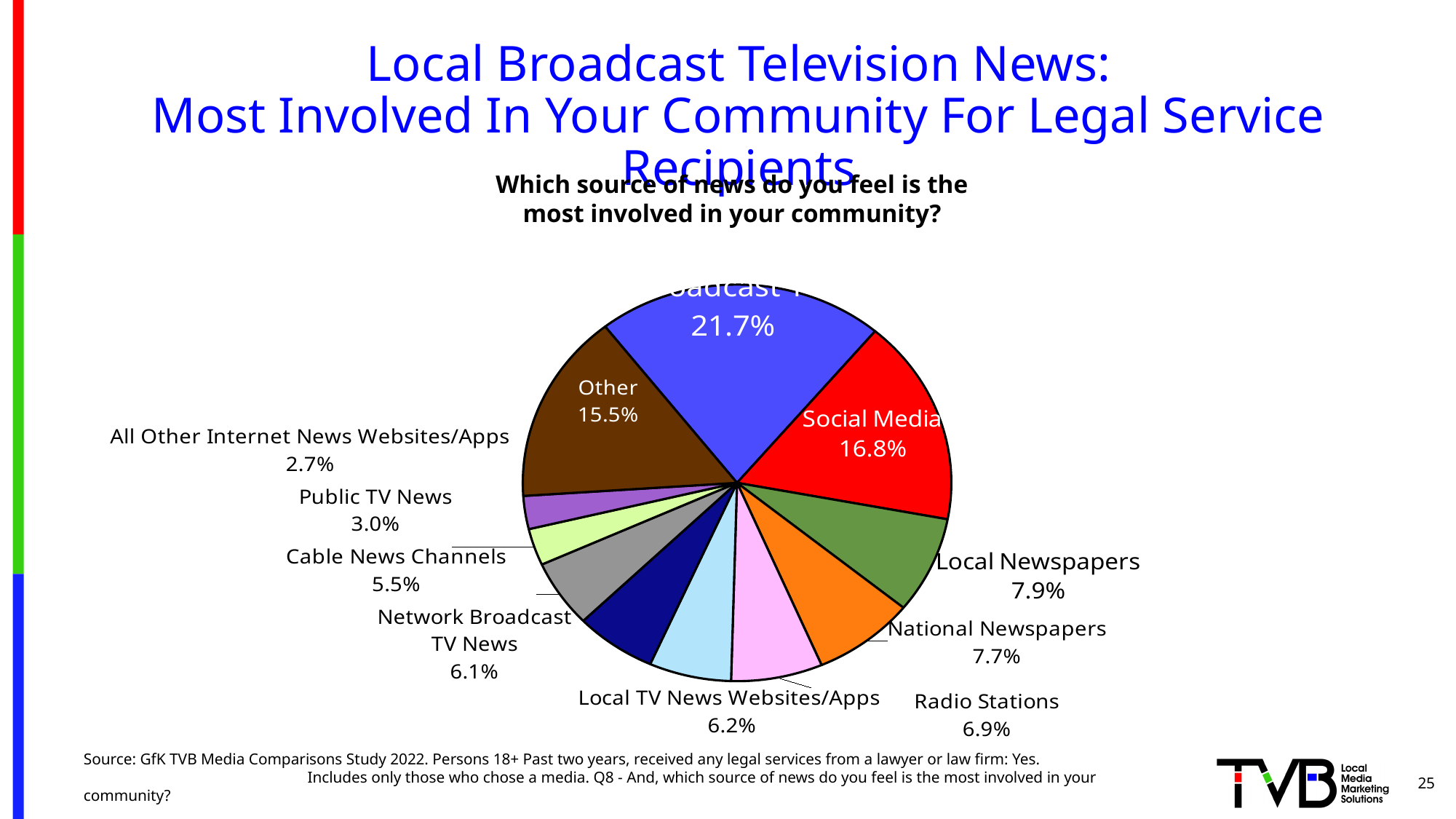
Which category has the smallest slice of the pie? All Other Internet News Websites/Apps What is the difference in percentage points between Social Media and Other? 1.3 percentage points What kind of chart is shown on the slide? Pie chart Which is larger, Local Newspapers or National Newspapers? Local Newspapers What is the value shown for the Other slice? 15.5% What percentage is shown for Local Newspapers? 7.9% What is the value of the largest slice in the pie chart? 21.7% What percentage of respondents chose Social Media as the news source most involved in their community? 16.8% How many slices does the pie chart have? 11 What is the value for Cable News Channels? 5.5% What is the value for Radio Stations? 6.9% What is the value for Network Broadcast TV News? 6.1%